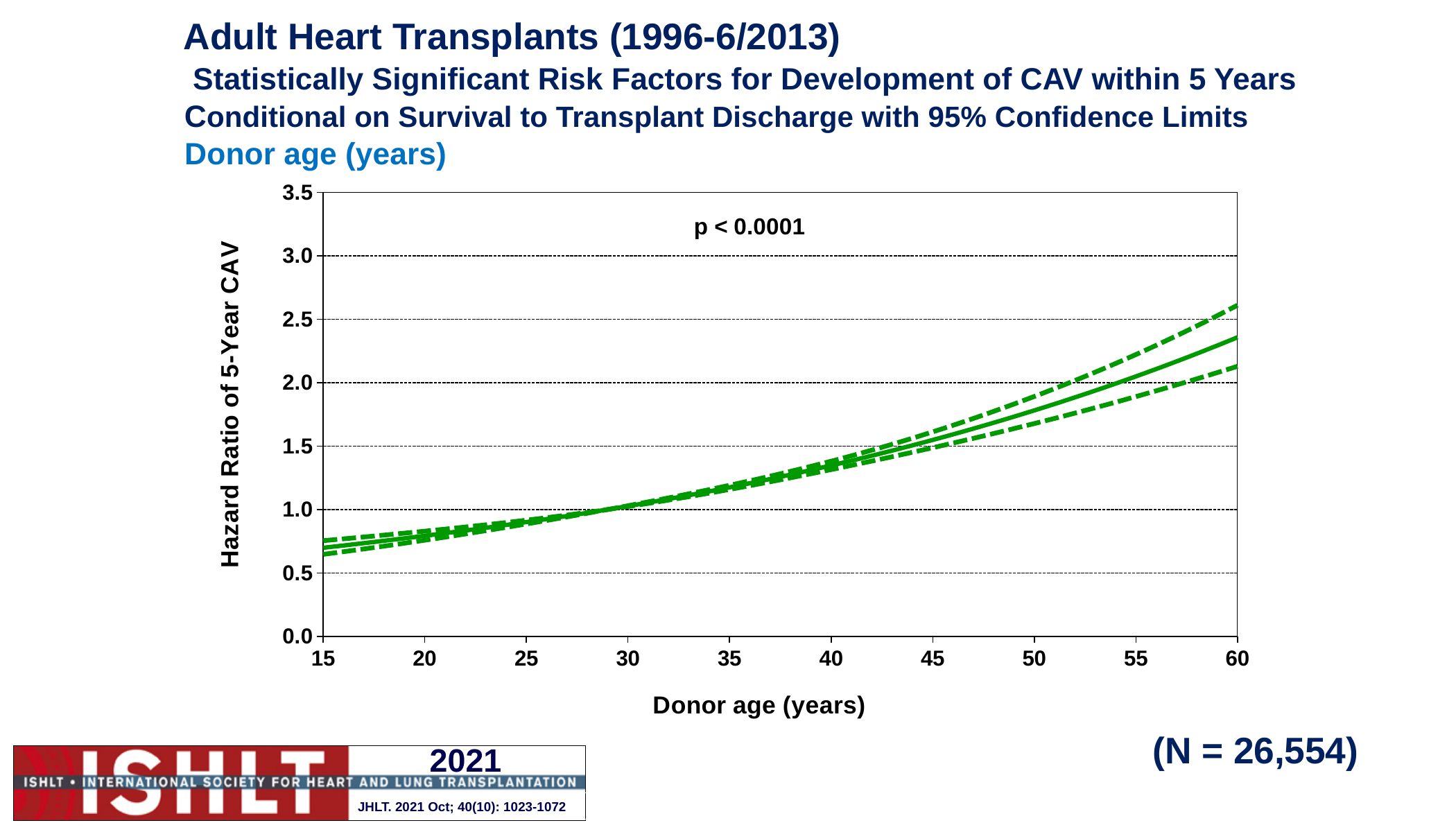
Is the hazard ratio for a donor age of 50 years greater or less than 1.5? greater What kind of chart is shown on the slide? line chart How many curves (solid and dashed) are drawn on the chart? 3 Is the hazard ratio for a donor age of 30 years greater or less than 1.5? less Is the hazard ratio for a donor age of 60 years greater or less than 2.0? greater What is the label of the y axis? Hazard Ratio of 5-Year CAV What p-value is printed on the chart? p < 0.0001 Does the hazard ratio of 5-year CAV rise or fall as donor age increases from 15 to 60 years? rise